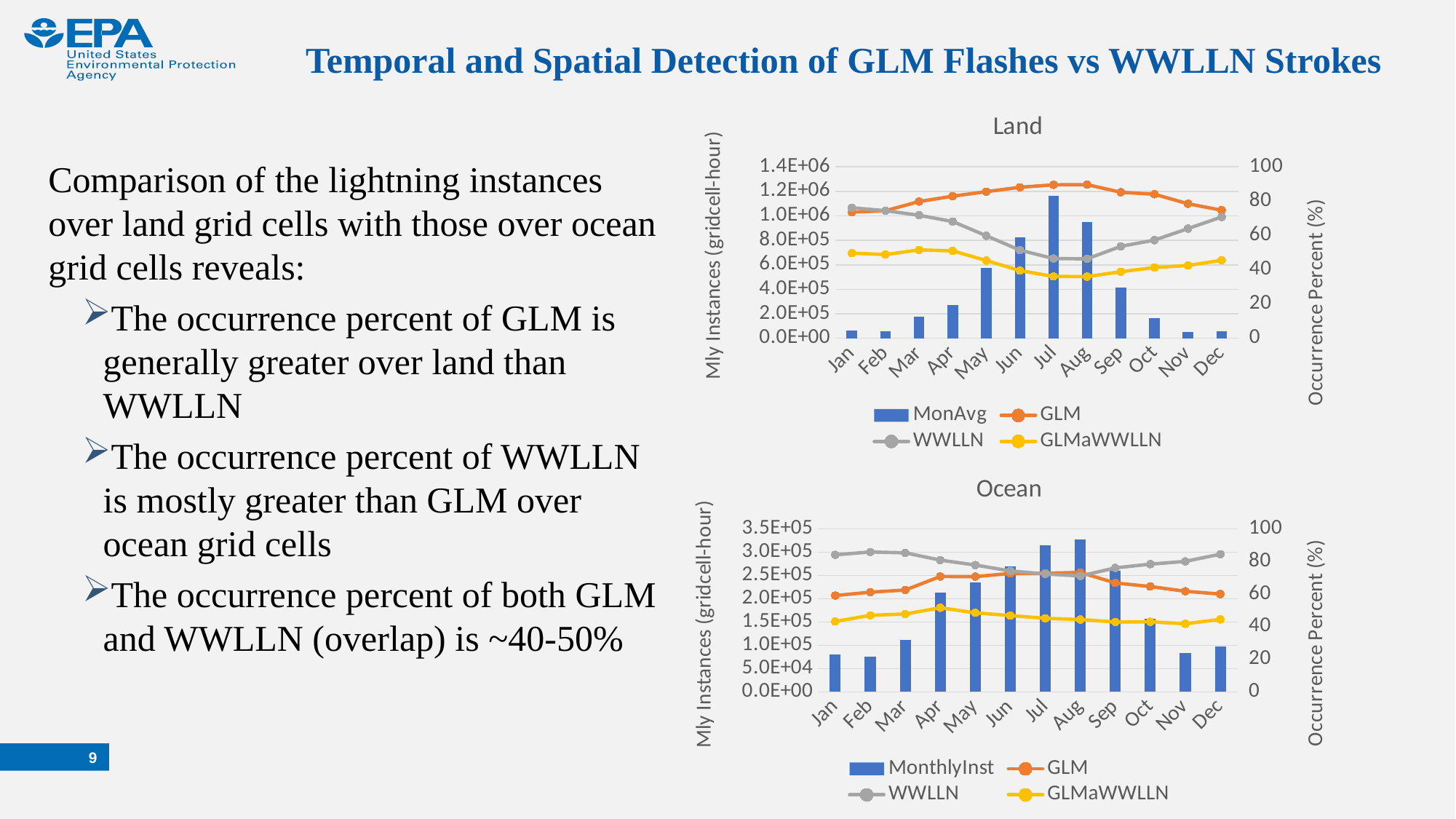
In the Ocean chart, which is larger in Jan: the GLM occurrence percent or the WWLLN occurrence percent? WWLLN In the Land chart, is the WWLLN occurrence percent for Jul greater or less than 60? less In the Land chart, which month has the highest MonAvg bar? Jul In the Ocean chart, is the MonthlyInst value for Jan greater or less than 1.0E+05? less How many months are shown on the x axis of the Land chart? 12 In the Ocean chart, is the WWLLN occurrence percent for Dec greater or less than 80? greater In the Land chart, which is larger in Jul: the GLM occurrence percent or the WWLLN occurrence percent? GLM In the Ocean chart, which month has the highest MonthlyInst bar? Aug In the Land chart, do the MonAvg bars rise or fall from Jan to Jul? rise How many series does the legend of the Ocean chart list? 4